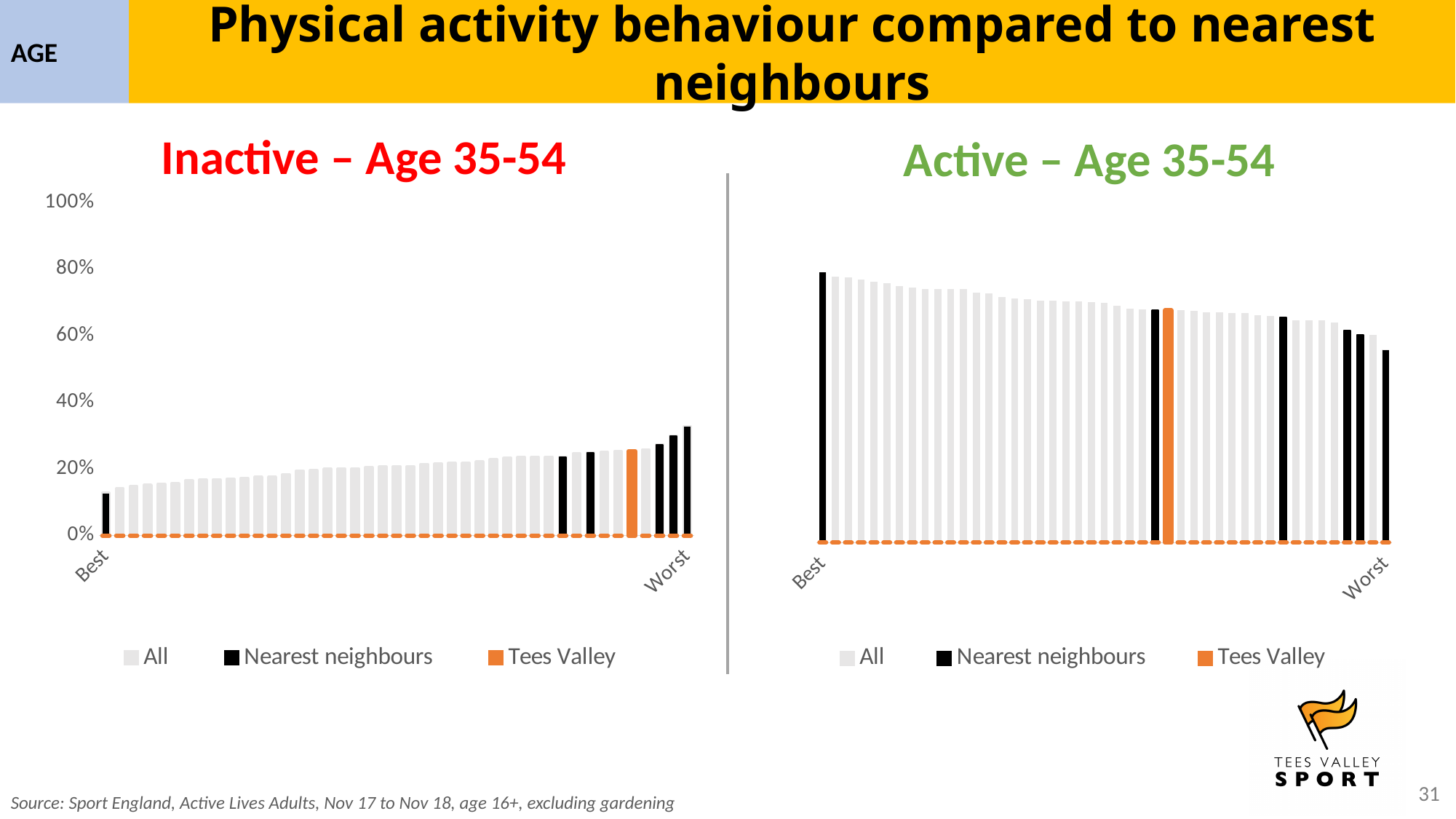
In the Active – Age 35-54 chart, is the value for Tees Valley greater or less than 60%? greater Which colour represents Tees Valley in the legend of the Inactive – Age 35-54 chart? orange In the Active – Age 35-54 chart, do the bars rise or fall from Best to Worst along the x axis? fall In the Inactive – Age 35-54 chart, do the bars rise or fall from Best to Worst along the x axis? rise In the Inactive – Age 35-54 chart, is the value for Tees Valley greater or less than 40%? less In the Inactive – Age 35-54 chart, is the value of the Best bar greater or less than 20%? less What kind of chart is the Inactive – Age 35-54 chart? bar chart What are the two labels shown on the x axis of the Active – Age 35-54 chart? Best and Worst How many series does the legend of the Active – Age 35-54 chart list? 3